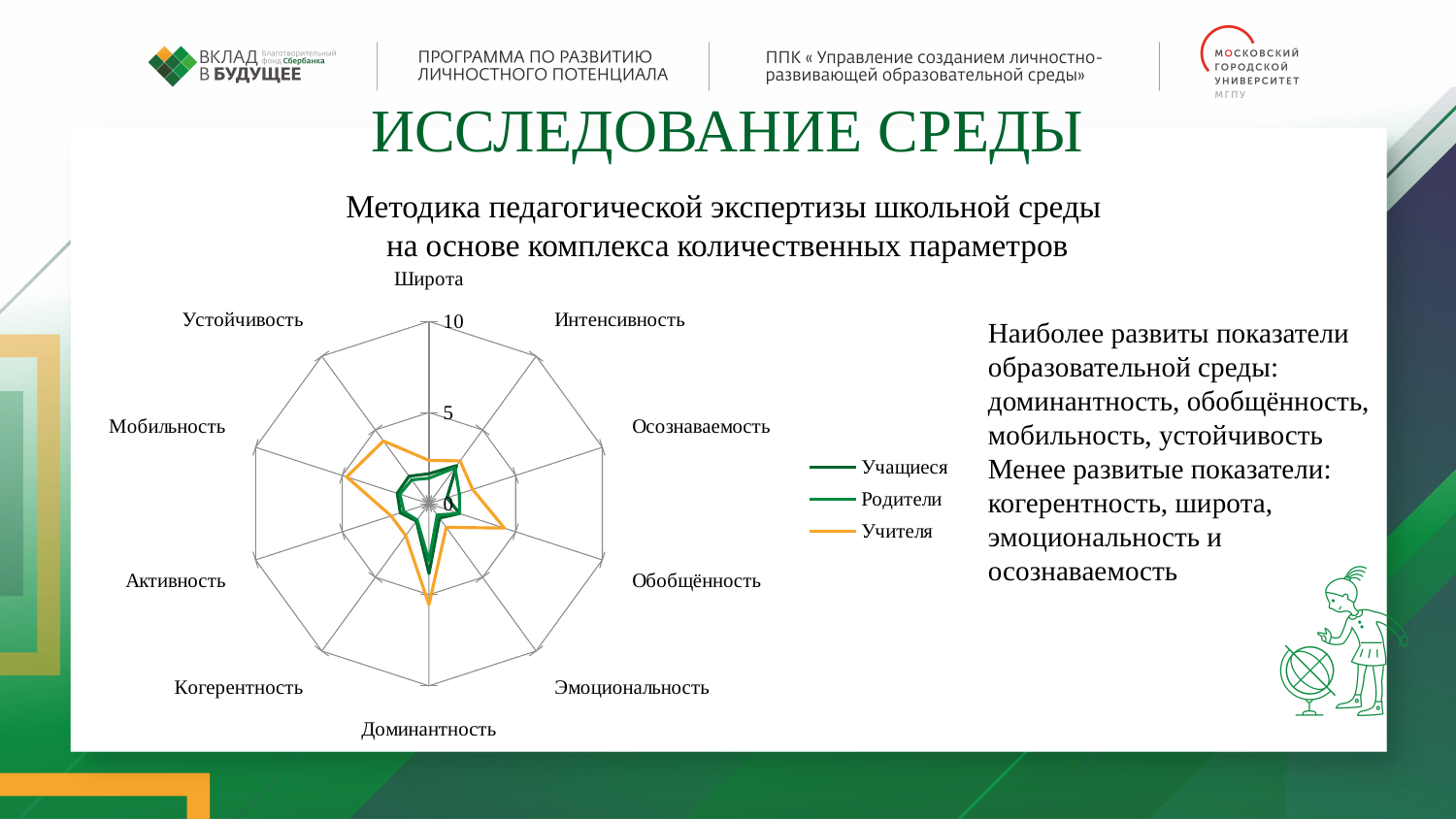
What kind of chart is shown on the slide? Radar chart Is the value for Учащиеся on the Осознаваемость axis greater or less than 5? less Is the value for Учителя on the Когерентность axis greater or less than 5? less Is the value for Учащиеся on the Широта axis greater or less than 5? less How many series does the chart legend list? 3 What is the maximum value shown on the radar chart's axis scale? 10 Which series has the larger value on the Обобщённость axis, Учителя or Учащиеся? Учителя Which series has the larger value on the Мобильность axis, Учителя or Учащиеся? Учителя How many parameters (axes) does the radar chart have? 10 Which series is drawn in orange on the chart? Учителя